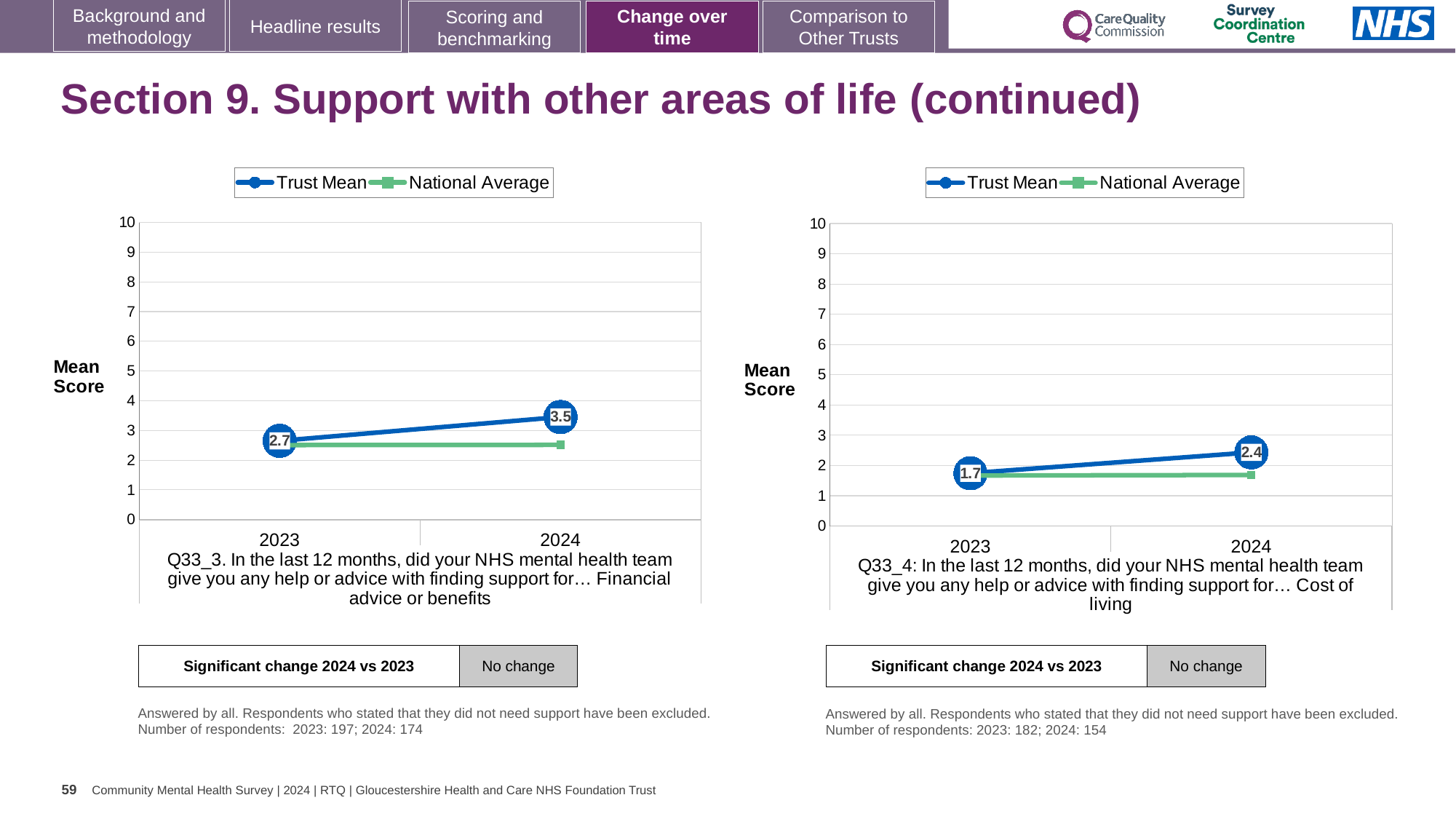
In the left chart (Q33_3, Financial advice or benefits), what is the Trust Mean for 2023? 2.7 In the right chart (Q33_4), which year has the higher Trust Mean? 2024 In the left chart (Q33_3), by how much did the Trust Mean change from 2023 to 2024? 0.8 In the left chart (Q33_3), is the Trust Mean or the National Average higher in 2024? Trust Mean What kind of chart is the left chart (Q33_3)? line chart How many series does the legend of the right chart (Q33_4) list? 2 In the left chart (Q33_3), does the Trust Mean rise or fall from 2023 to 2024? rise In the left chart (Q33_3), is the National Average for 2024 greater or less than 3? less In the right chart (Q33_4), what is the difference between the Trust Mean in 2024 and in 2023? 0.7 In the right chart (Q33_4, Cost of living), what is the Trust Mean for 2023? 1.7 In the left chart (Q33_3, Financial advice or benefits), what is the Trust Mean for 2024? 3.5 In the right chart (Q33_4, Cost of living), what is the Trust Mean for 2024? 2.4